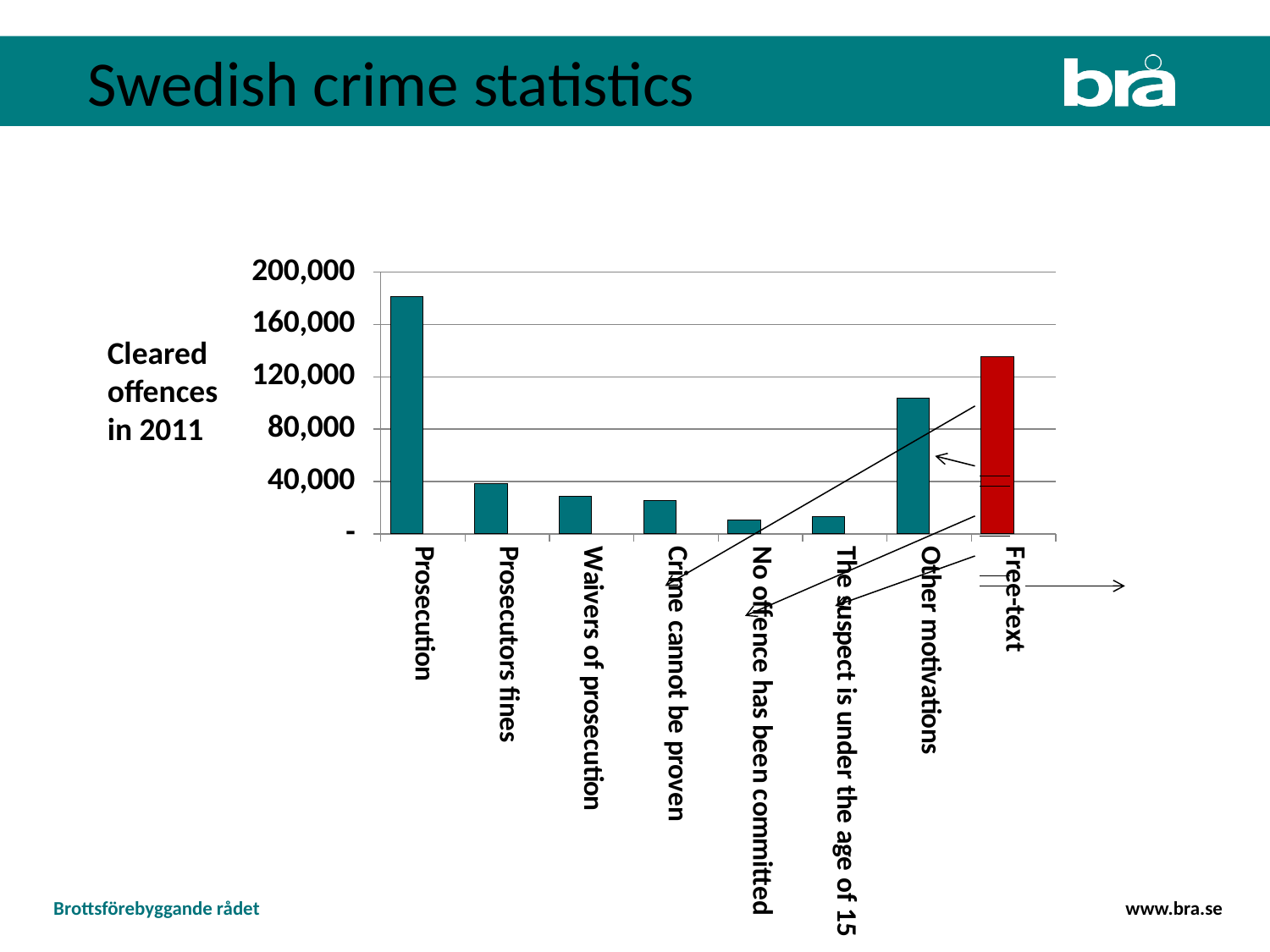
Is the value for Waivers of prosecution greater or less than 40,000? less Is the value for Prosecution greater or less than 160,000? greater Is the value for Free-text greater or less than 120,000? greater Which category's bar is coloured red in the chart? Free-text Which is larger, the value for Prosecution or the value for Free-text? Prosecution How many categories are shown on the x axis of the chart? 8 What kind of chart is shown on the slide? bar chart What does the label to the left of the chart say the data represents? Cleared offences in 2011 Which category has the highest value in the chart? Prosecution Which is larger, the value for Other motivations or the value for Crime cannot be proven? Other motivations